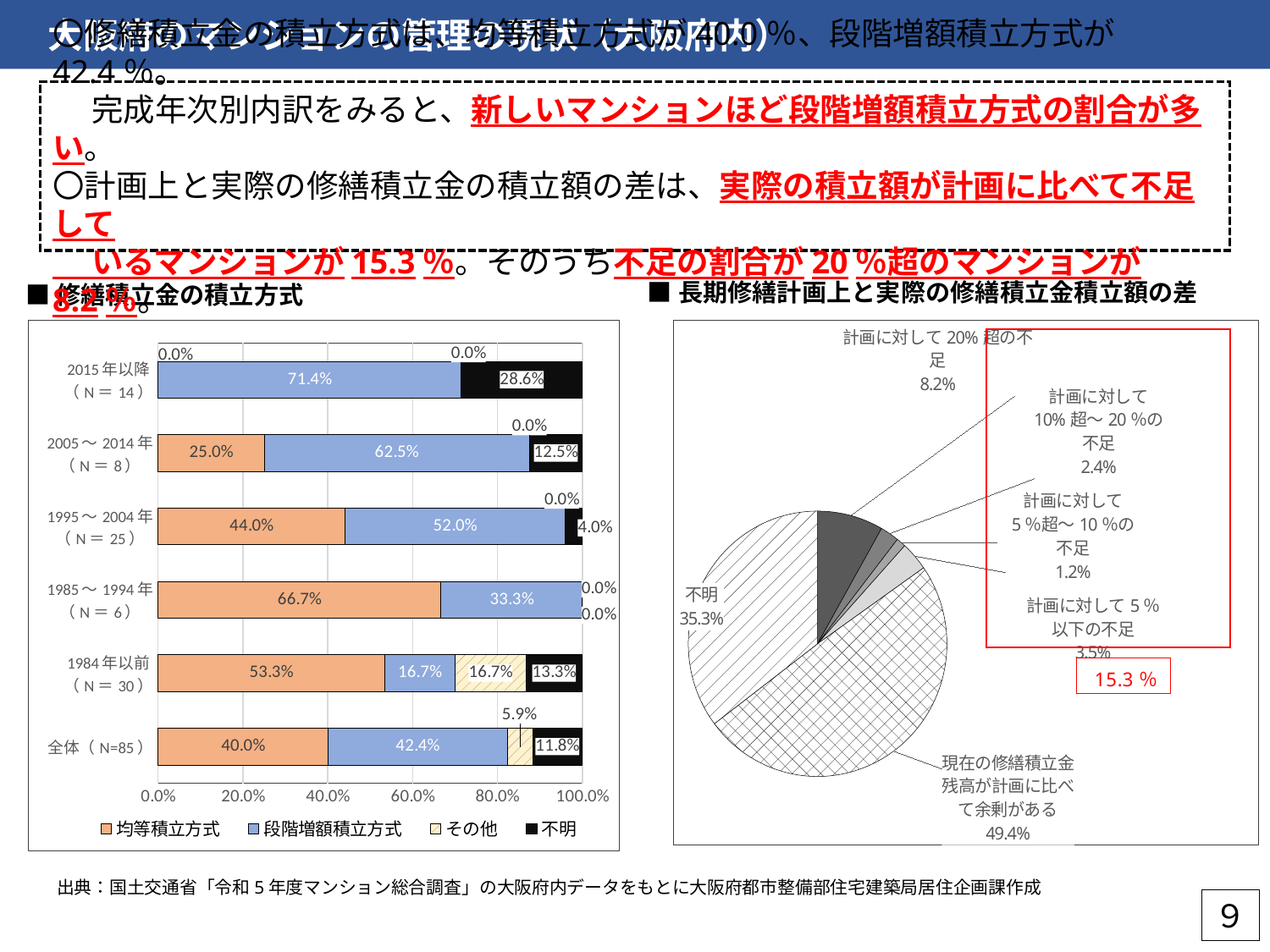
In the bar chart 修繕積立金の積立方式, what is the value of 段階増額積立方式 for 2015年以降 (N=14)? 71.4% In the bar chart 修繕積立金の積立方式, which completion-year group has the highest value for 均等積立方式? 1985～1994年 (N=6) In the bar chart 修繕積立金の積立方式, what is the value of 均等積立方式 for 全体 (N=85)? 40.0% How many completion-year categories are shown in the bar chart 修繕積立金の積立方式? 6 In the pie chart 長期修繕計画上と実際の修繕積立金積立額の差, what share is 現在の修繕積立金残高が計画に比べて余剰がある? 49.4% In the pie chart 長期修繕計画上と実際の修繕積立金積立額の差, what is the value of 不明? 35.3% In the pie chart 長期修繕計画上と実際の修繕積立金積立額の差, which slice is the smallest? 計画に対して5%超～10%の不足 How many series does the legend of the bar chart 修繕積立金の積立方式 list? 4 In the bar chart 修繕積立金の積立方式, what is the value of 不明 for 2005～2014年 (N=8)? 12.5% In the bar chart 修繕積立金の積立方式, which is larger for 1984年以前 (N=30): 均等積立方式 or 段階増額積立方式? 均等積立方式 What type of chart is 長期修繕計画上と実際の修繕積立金積立額の差? Pie chart In the bar chart 修繕積立金の積立方式, what is the difference between 均等積立方式 and 段階増額積立方式 for 1995～2004年 (N=25)? 8.0%